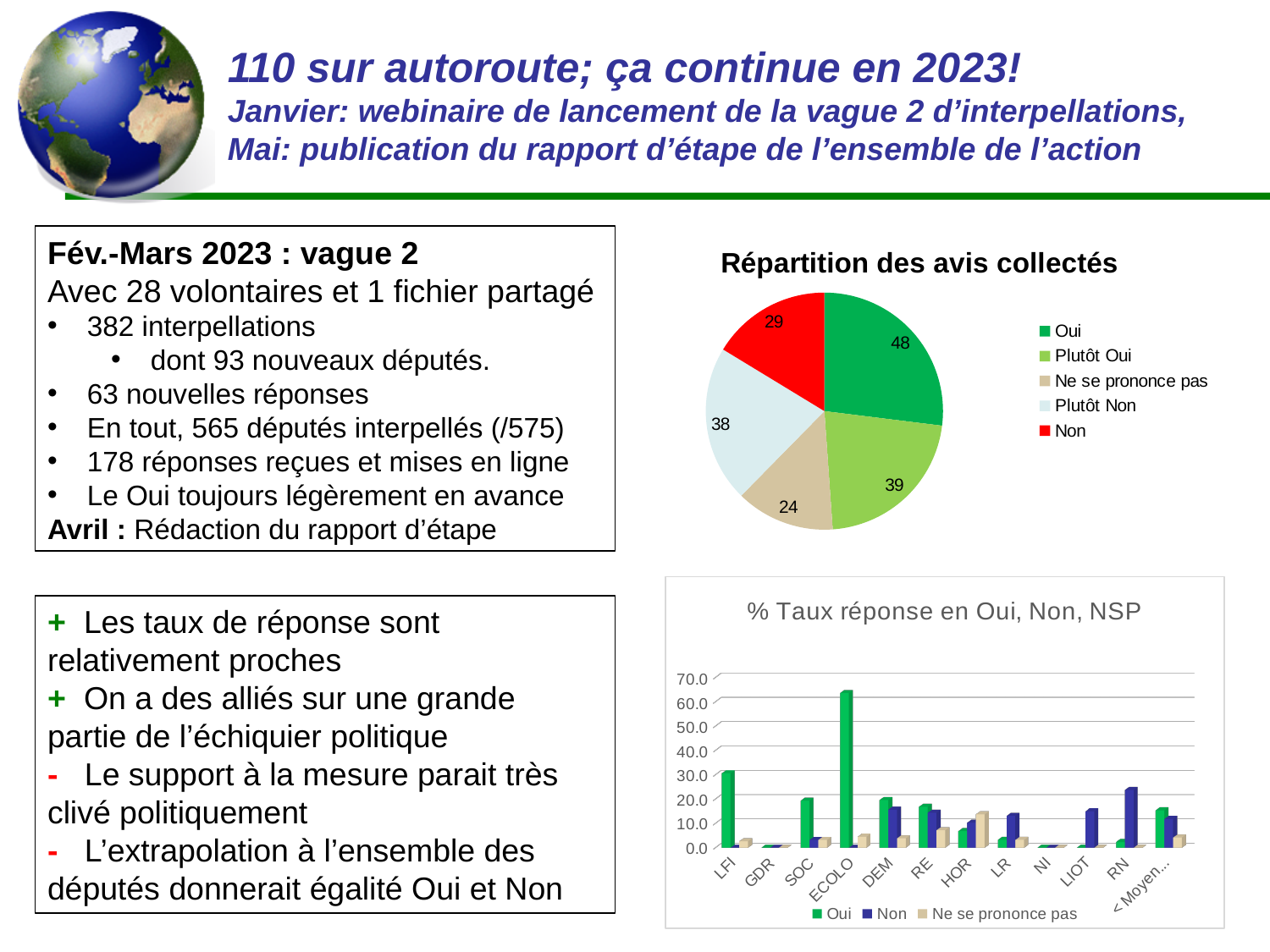
In the chart '% Taux réponse en Oui, Non, NSP', is the 'Oui' value for ECOLO greater or less than 60.0? greater How many series does the legend of the chart '% Taux réponse en Oui, Non, NSP' list? 3 In the pie chart 'Répartition des avis collectés', which is larger: 'Plutôt Oui' or 'Plutôt Non'? Plutôt Oui In the pie chart 'Répartition des avis collectés', what is the value for 'Oui'? 48 In the chart '% Taux réponse en Oui, Non, NSP', which category has the highest 'Oui' bar? ECOLO In the chart '% Taux réponse en Oui, Non, NSP', which category has the highest 'Non' bar? RN What type of chart is '% Taux réponse en Oui, Non, NSP'? Bar chart In the pie chart 'Répartition des avis collectés', what is the value for 'Ne se prononce pas'? 24 How many categories does the pie chart 'Répartition des avis collectés' show? 5 In the pie chart 'Répartition des avis collectés', which category has the smallest slice? Ne se prononce pas In the pie chart 'Répartition des avis collectés', what is the difference between 'Oui' and 'Non'? 19 In the pie chart 'Répartition des avis collectés', which category has the largest slice? Oui